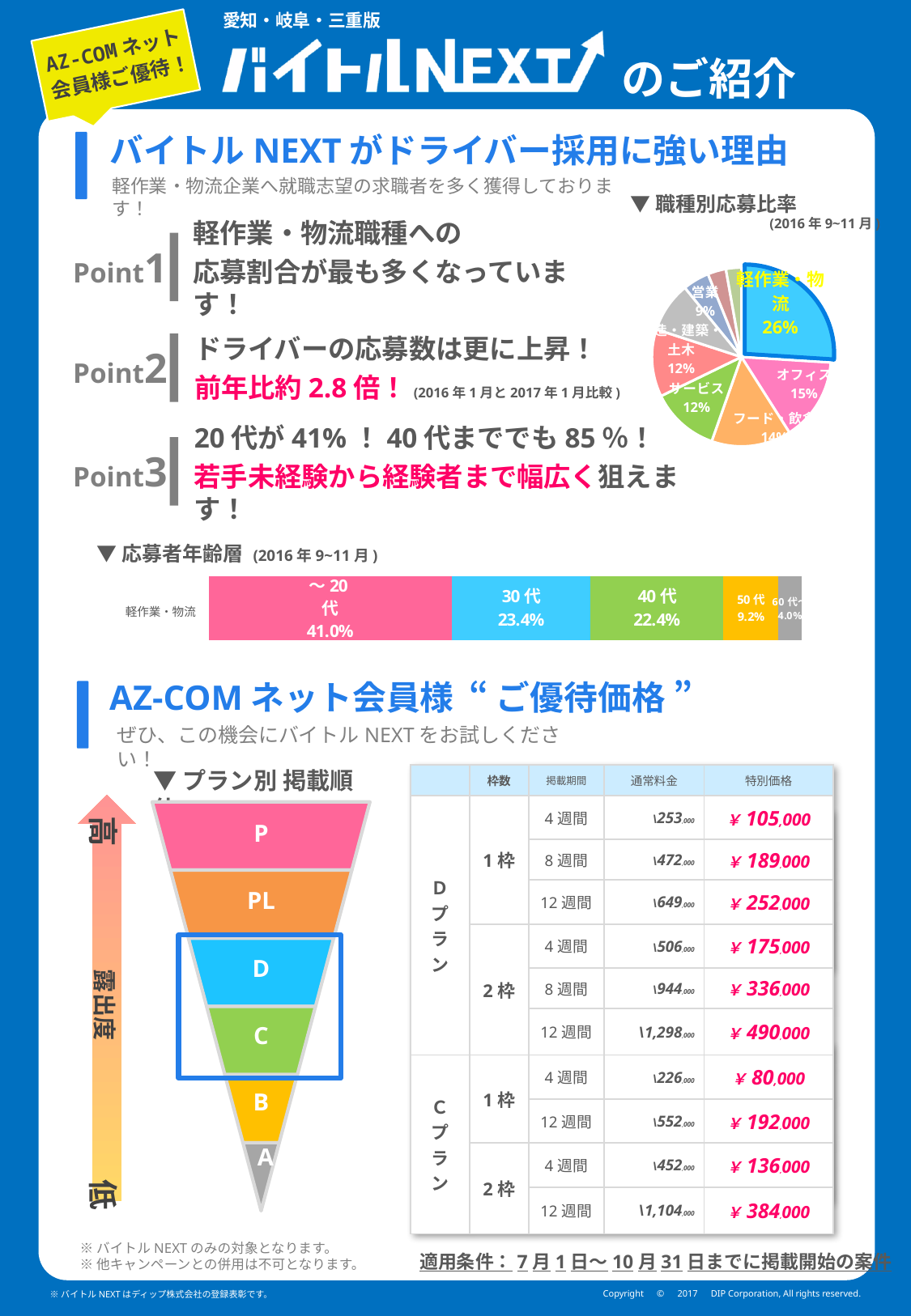
In the pie chart titled 職種別応募比率, what percentage is shown for 軽作業・物流? 26% How many age-group segments are shown in the 応募者年齢層 bar chart? 5 In the pie chart titled 職種別応募比率, what percentage is shown for オフィス? 15% In the pie chart titled 職種別応募比率, which is larger, オフィス or サービス? オフィス In the 応募者年齢層 bar chart, what is the difference between the 30代 and 40代 values? 1.0 percentage point In the 応募者年齢層 bar chart, what percentage is shown for 50代? 9.2% In the pie chart titled 職種別応募比率, how many percentage points larger is 軽作業・物流 than オフィス? 11 percentage points In the pie chart titled 職種別応募比率, which category has the largest slice? 軽作業・物流 In the 応募者年齢層 bar chart, what percentage is shown for ～20代? 41.0% What kind of chart is the 職種別応募比率 chart? Pie chart In the pie chart titled 職種別応募比率, what percentage is shown for 営業? 9% In the 応募者年齢層 bar chart, which age group has the smallest share? 60代～